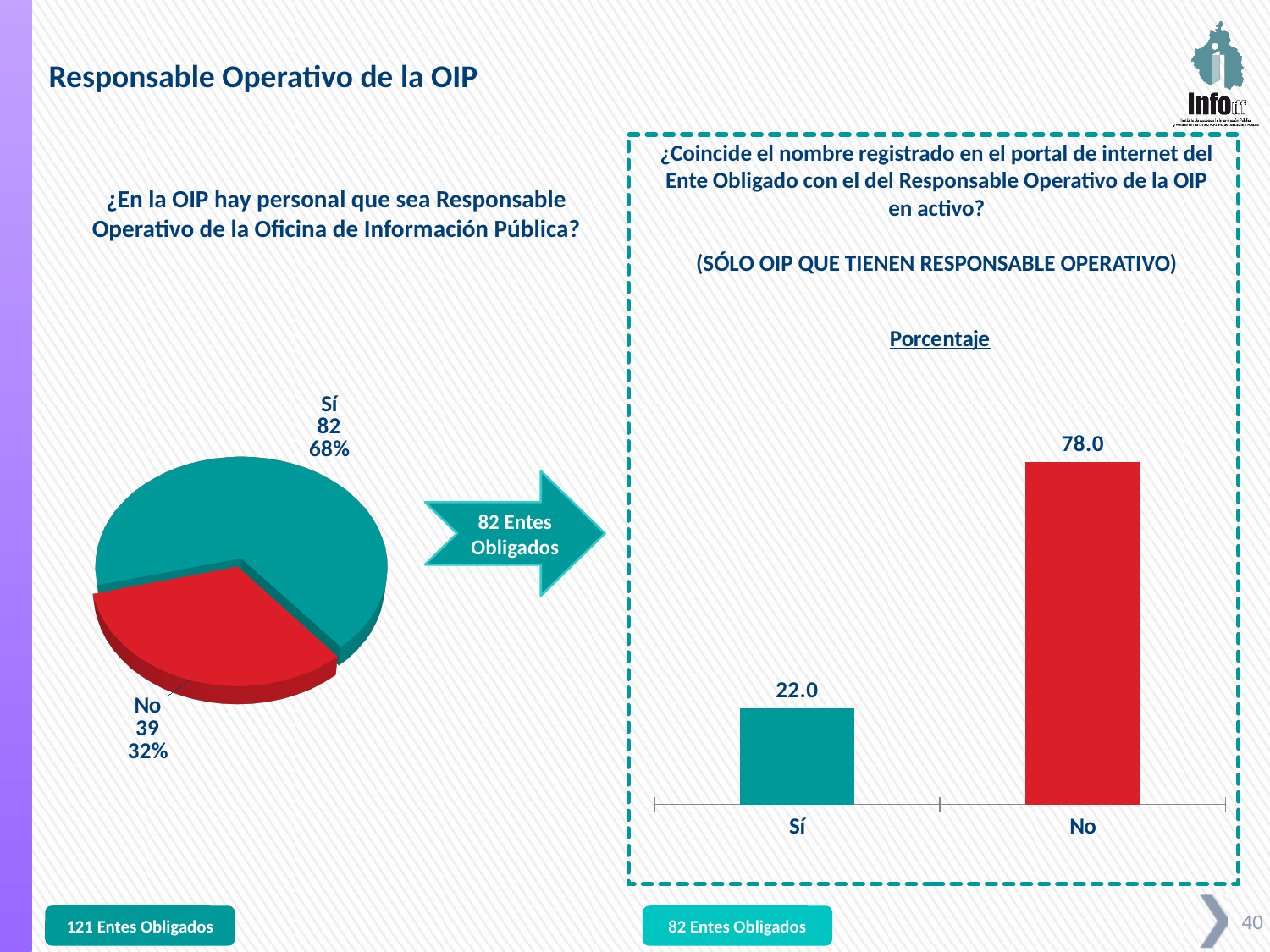
In the bar chart on the right, what colour is the 'No' bar? Red What kind of chart is shown on the right side of the slide? Bar chart What kind of chart is shown on the left side of the slide? Pie chart In the bar chart on the right, what is the value for 'Sí'? 22.0 In the pie chart on the left, what percentage share does the 'No' slice have? 32% In the bar chart on the right, which category has the highest value? No In the pie chart on the left, how many Entes Obligados answered 'Sí'? 82 In the bar chart on the right, what is the value for 'No'? 78.0 In the bar chart on the right, what is the difference between the 'No' and 'Sí' values? 56.0 In the pie chart on the left, which category has the larger slice, 'Sí' or 'No'? Sí In the pie chart on the left, how many slices are there? 2 In the pie chart on the left, what is the difference in count between 'Sí' and 'No'? 43